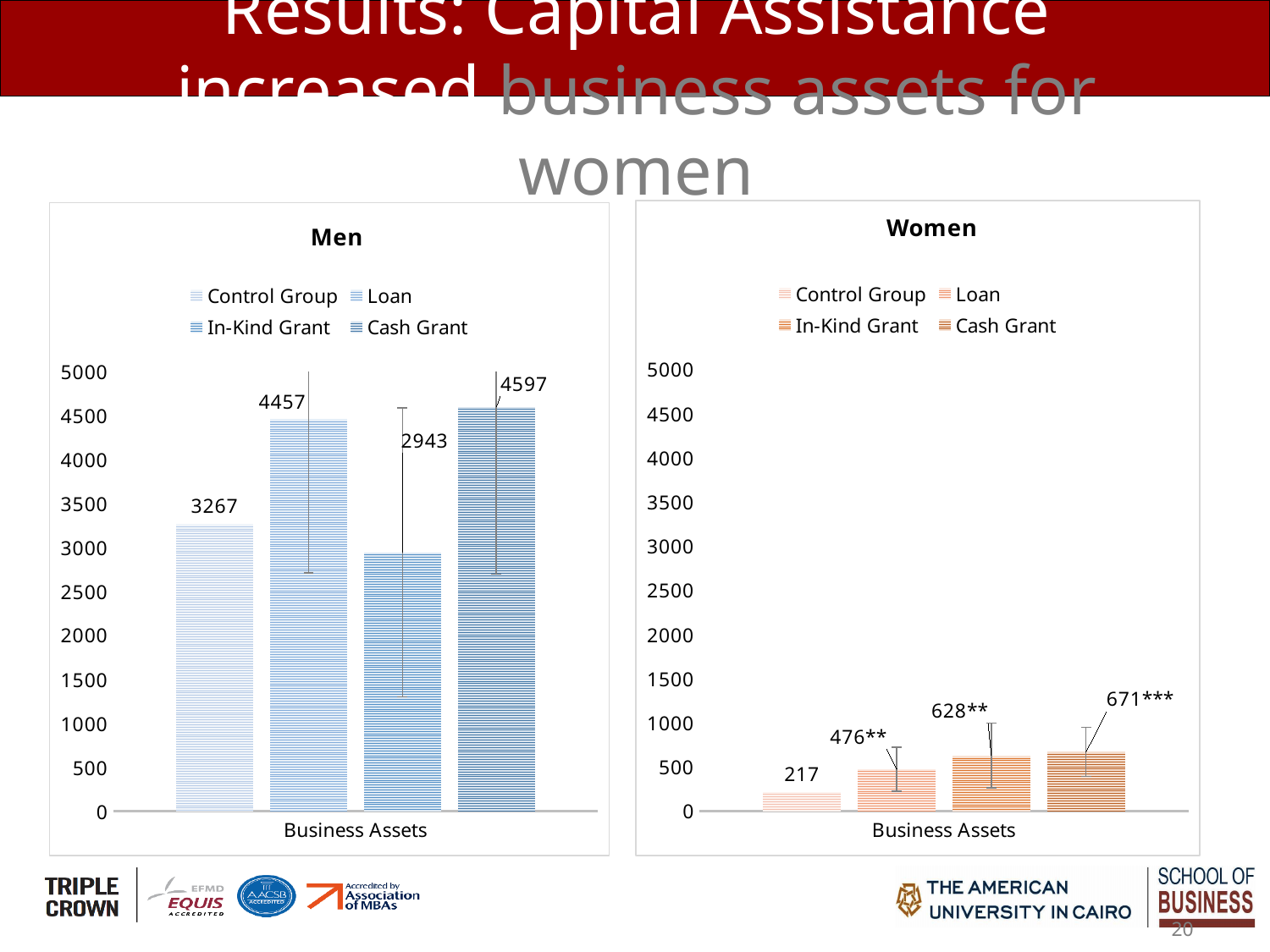
In the Men chart, what is the value for the Control Group? 3267 In the Men chart, what is the value for the Cash Grant series? 4597 What kind of chart is the Men chart? Bar chart In the Women chart, what is the difference between the Cash Grant value and the Control Group value? 454 How many series does the legend of the Women chart list? 4 In the Men chart, which series has the lowest value? In-Kind Grant In the Women chart, what is the value labelled for the In-Kind Grant series? 628** In the Men chart, what is the difference between the Loan value and the Control Group value? 1190 In the Women chart, what is the value for the Control Group? 217 What is the x-axis category label shown in the Women chart? Business Assets In the Men chart, which is larger, the Loan value or the In-Kind Grant value? Loan In the Women chart, which series has the highest value? Cash Grant